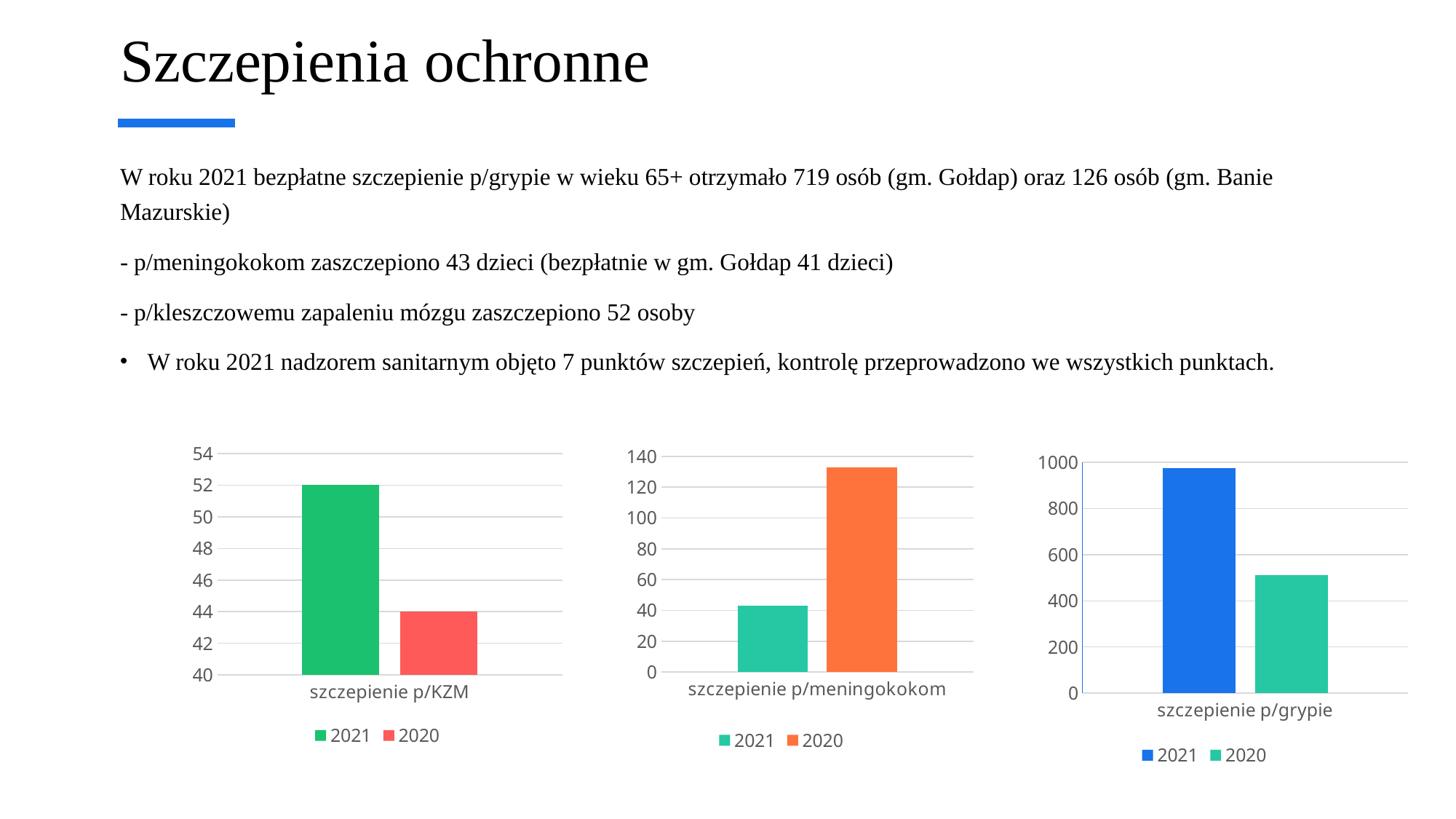
In the right chart (szczepienie p/grypie), is the value for 2020 greater or less than 600? less What kind of chart is the middle chart (szczepienie p/meningokokom)? bar chart In the right chart (szczepienie p/grypie), which year has the lower value? 2020 In the middle chart (szczepienie p/meningokokom), is the value for 2020 greater or less than 120? greater In the left chart (szczepienie p/KZM), what is the value for 2020? 44 In the left chart (szczepienie p/KZM), what is the difference between the 2021 and 2020 values? 8 How many series does the legend of the right chart (szczepienie p/grypie) list? 2 In the left chart (szczepienie p/KZM), what is the value for 2021? 52 In the middle chart (szczepienie p/meningokokom), which year has the higher value? 2020 In the middle chart (szczepienie p/meningokokom), is the value for 2021 greater or less than 60? less In the left chart (szczepienie p/KZM), which year has the higher value, 2021 or 2020? 2021